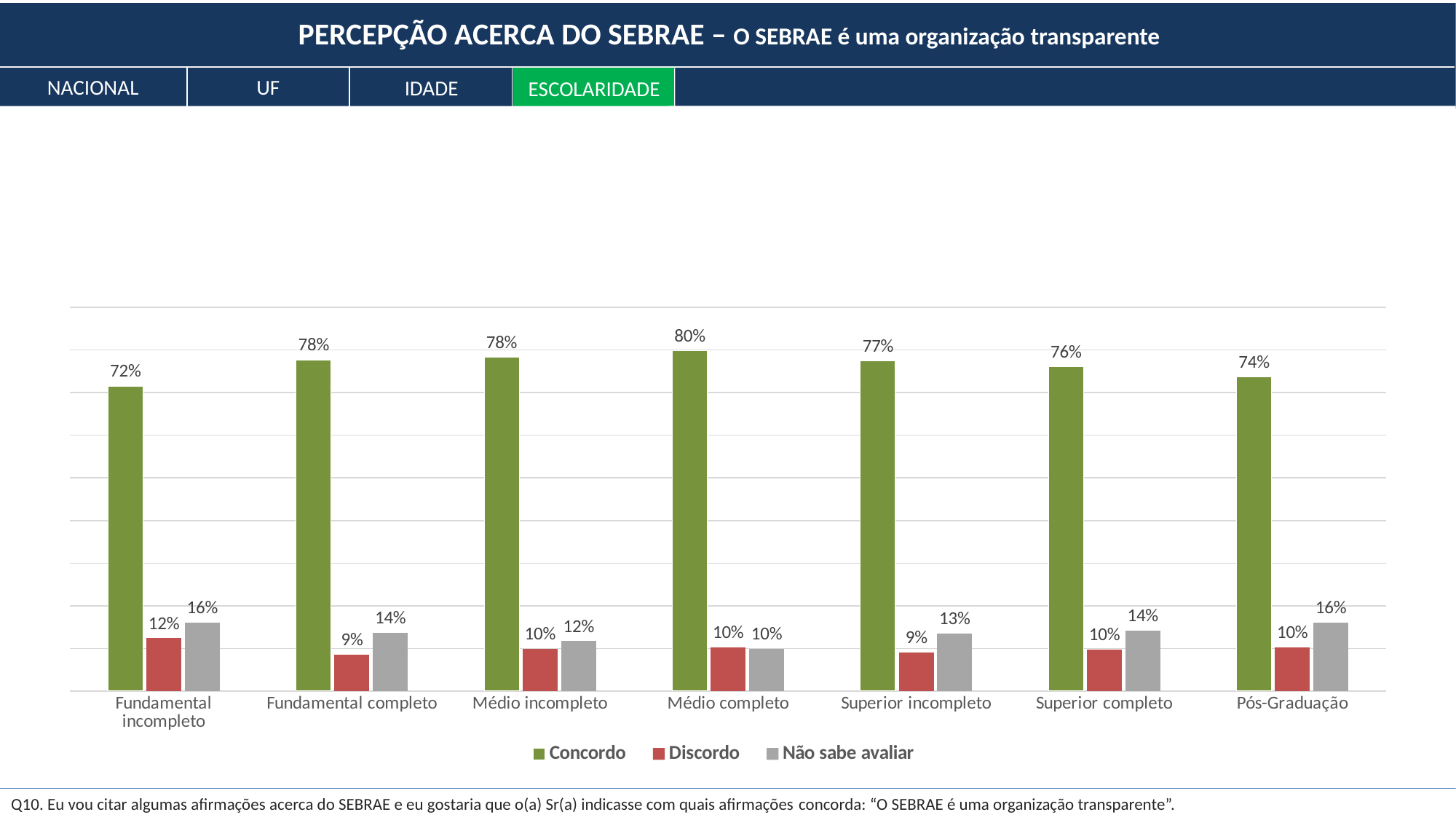
Which education level has the highest Concordo value? Médio completo What is the Discordo value for Fundamental incompleto? 12% Which education level has the lowest Concordo value? Fundamental incompleto How many series does the legend list? 3 What kind of chart is shown on the slide? Bar chart Which is larger, the Não sabe avaliar value for Pós-Graduação or for Médio completo? Pós-Graduação What is the Não sabe avaliar value for Superior incompleto? 13% How many education level categories are shown on the x axis? 7 What is the difference between the Concordo values for Médio completo and Fundamental incompleto? 8% Which tab is highlighted in green at the top of the slide? ESCOLARIDADE What is the total of the three values for Superior completo? 100% What is the Concordo value for Médio completo? 80%